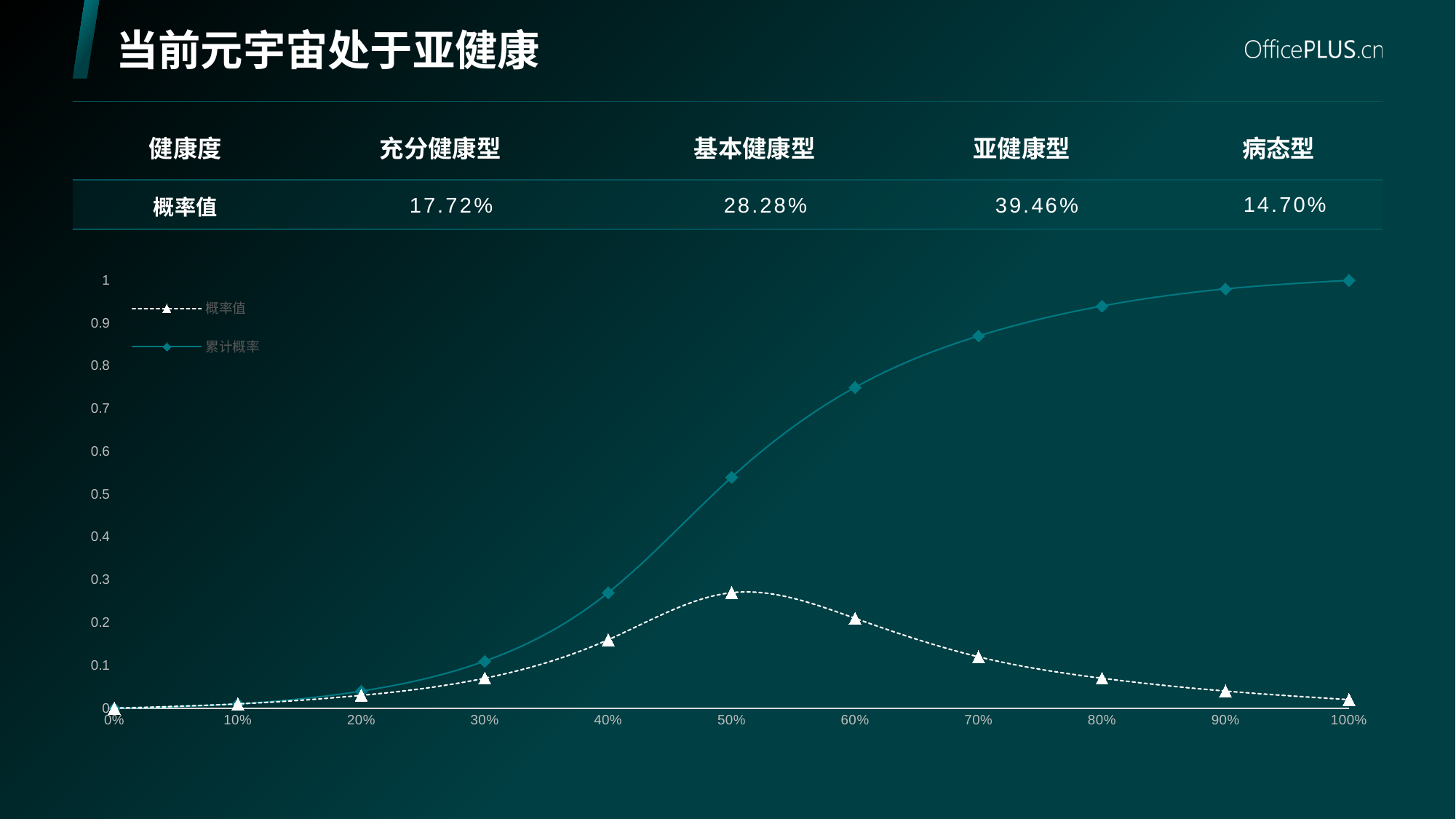
Is the value of 累计概率 at 80% greater or less than 0.9? greater How many x-axis categories (points) does each series have in the chart? 11 What kind of chart is shown on the slide? line chart Does the 累计概率 series rise or fall as the x axis goes from 0% to 100%? rise At which x-axis value does the 累计概率 series reach its highest point? 100% Is the value of 累计概率 at 40% greater or less than 0.3? less Is the value of 概率值 at 50% greater or less than 0.3? less How many series does the chart legend list? 2 What are the two series named in the chart legend? 概率值 and 累计概率 At 60%, which series has the higher value, 概率值 or 累计概率? 累计概率 At which x-axis value does the 概率值 series reach its highest point? 50%